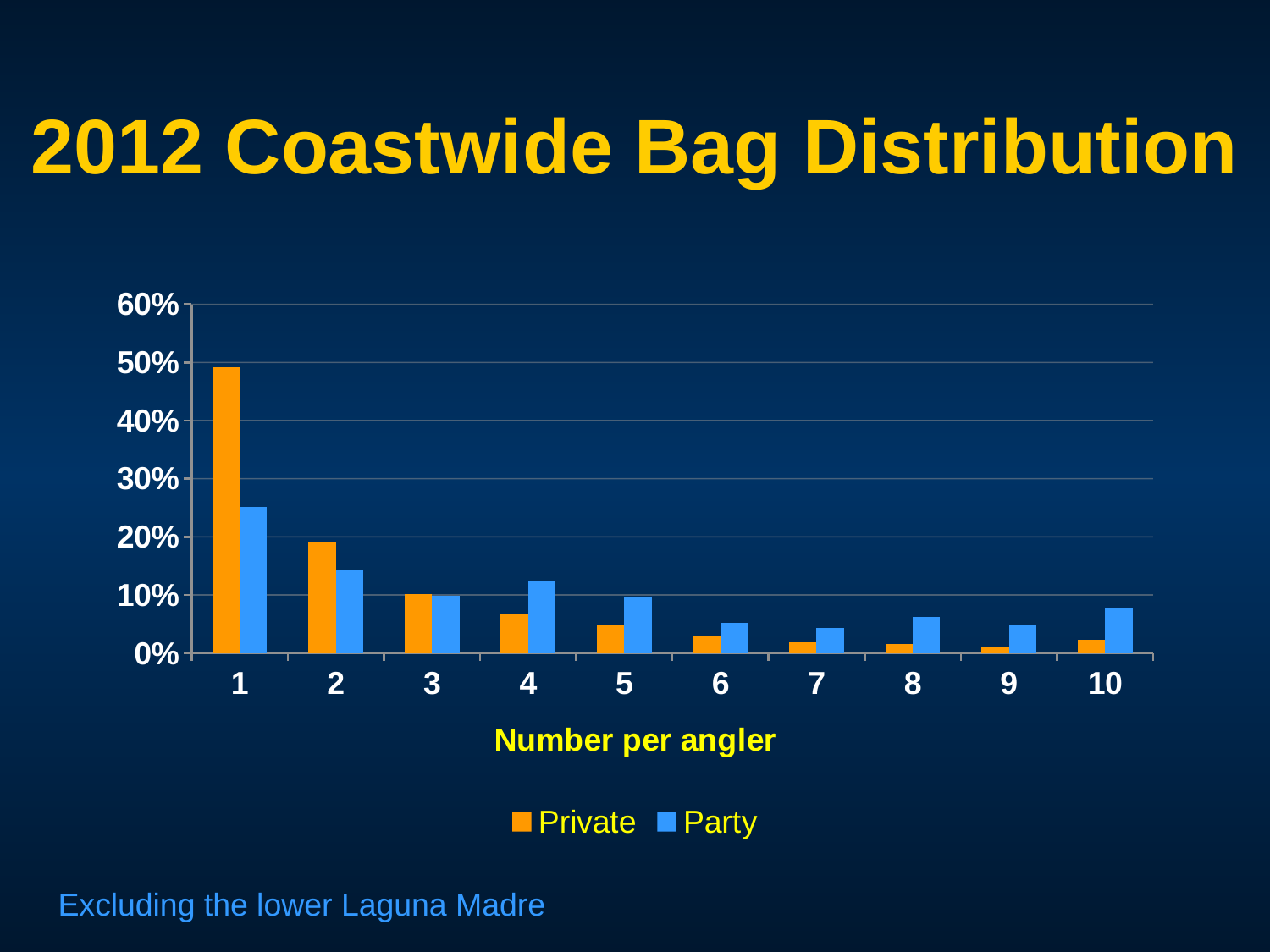
For which number per angler is the Party value highest? 1 Do the Private values generally rise or fall as the number per angler increases from 1 to 9? fall Is the Private value at 1 per angler greater or less than 40%? greater How many categories are shown along the x axis? 10 At 4 per angler, which series has the larger value, Private or Party? Party How many series does the legend list? 2 For which number per angler is the Private value highest? 1 What kind of chart is shown on the slide? bar chart At 1 per angler, which series has the larger value, Private or Party? Private What is the title of the x axis? Number per angler For which number per angler is the Private value lowest? 9 Is the Party value at 1 per angler greater or less than 20%? greater